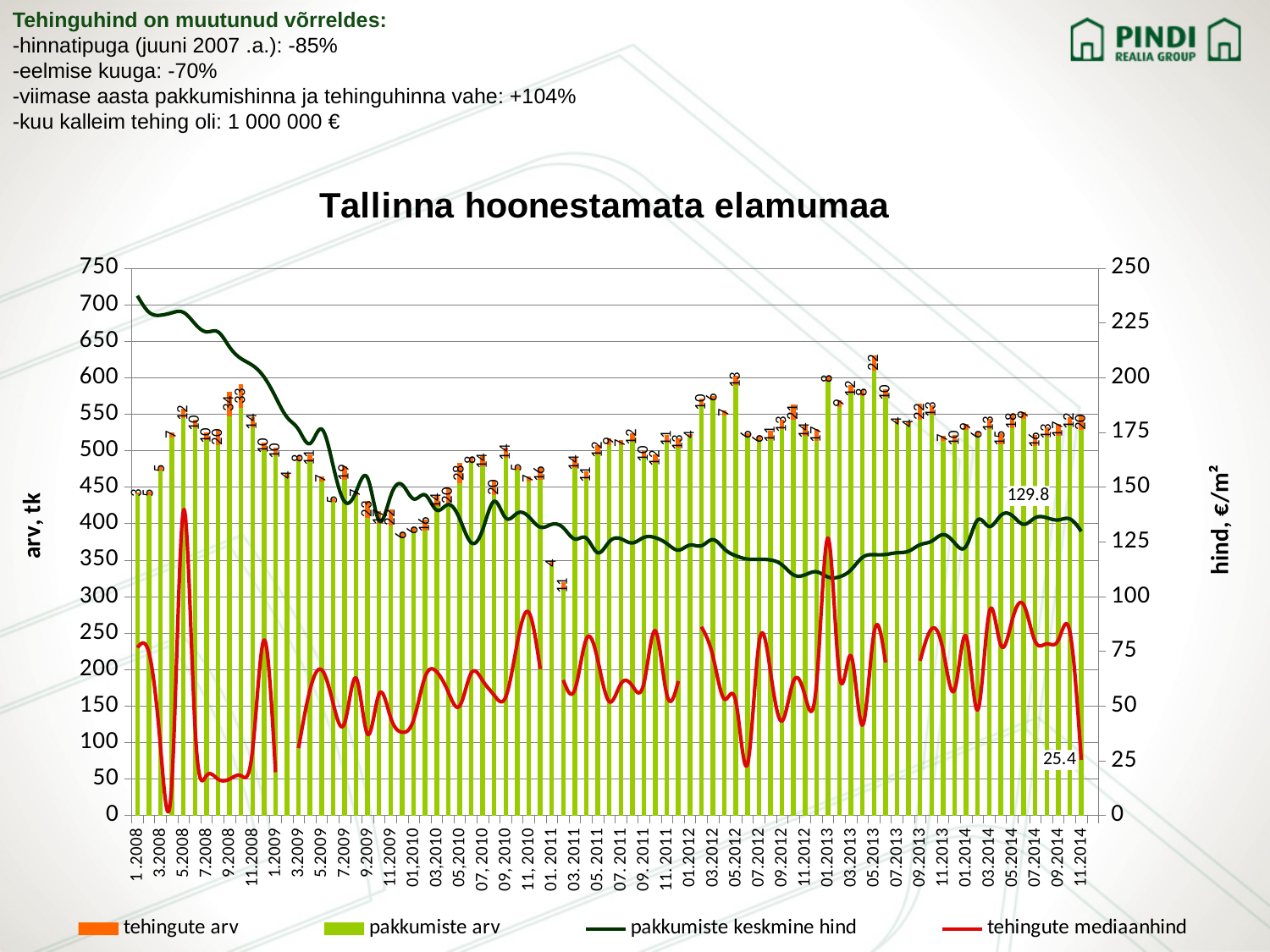
At 11.2014, which is larger: pakkumiste keskmine hind or tehingute mediaanhind? pakkumiste keskmine hind What is the value of pakkumiste keskmine hind at 11.2014? 129.8 What is the value of tehingute mediaanhind at 11.2014? 25.4 What is the difference between pakkumiste keskmine hind and tehingute mediaanhind at 11.2014? 104.4 Which month has the highest pakkumiste arv? 05.2013 What is the title of the chart? Tallinna hoonestamata elamumaa Is the value of pakkumiste keskmine hind at 1.2008 greater or less than 225? greater Is the value of pakkumiste keskmine hind at 01.2013 greater or less than 125? less What is the label of the right-hand vertical axis? hind, €/m² How many series does the chart legend list? 4 What kind of chart is shown on the slide? Combined bar and line chart Does pakkumiste keskmine hind rise or fall between 1.2008 and 1.2010? fall